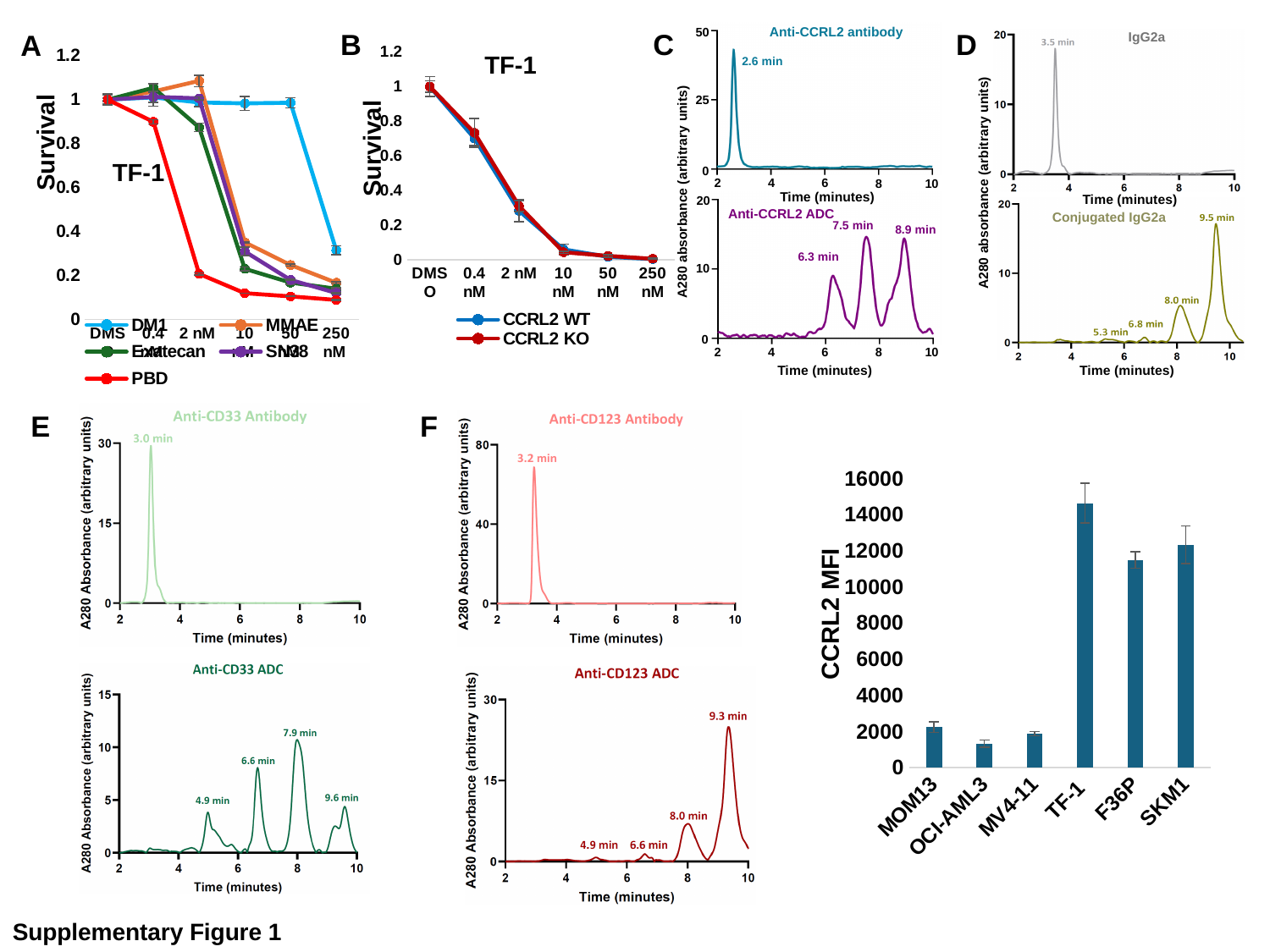
In the CCRL2 MFI bar chart, which cell line has the highest CCRL2 MFI? TF-1 In the CCRL2 MFI bar chart, how many cell lines are shown on the x axis? 6 In the CCRL2 MFI bar chart, is the value for TF-1 greater or less than 12000? greater In the CCRL2 MFI bar chart, is the value for OCI-AML3 greater or less than 2000? less In panel C, at what time does the Anti-CCRL2 antibody peak occur? 2.6 min In panel B (TF-1 survival chart), how many series does the legend list? 2 In panel B, do the survival values rise or fall as concentration increases along the x axis? fall In the CCRL2 MFI bar chart, which has a larger CCRL2 MFI, F36P or MOM13? F36P In panel D, at what time does the IgG2a peak occur? 3.5 min In panel A (TF-1 survival chart), how many series does the legend list? 5 In the CCRL2 MFI bar chart, which cell line has the lowest CCRL2 MFI? OCI-AML3 What kind of chart is the CCRL2 MFI chart on the right of the slide? bar chart